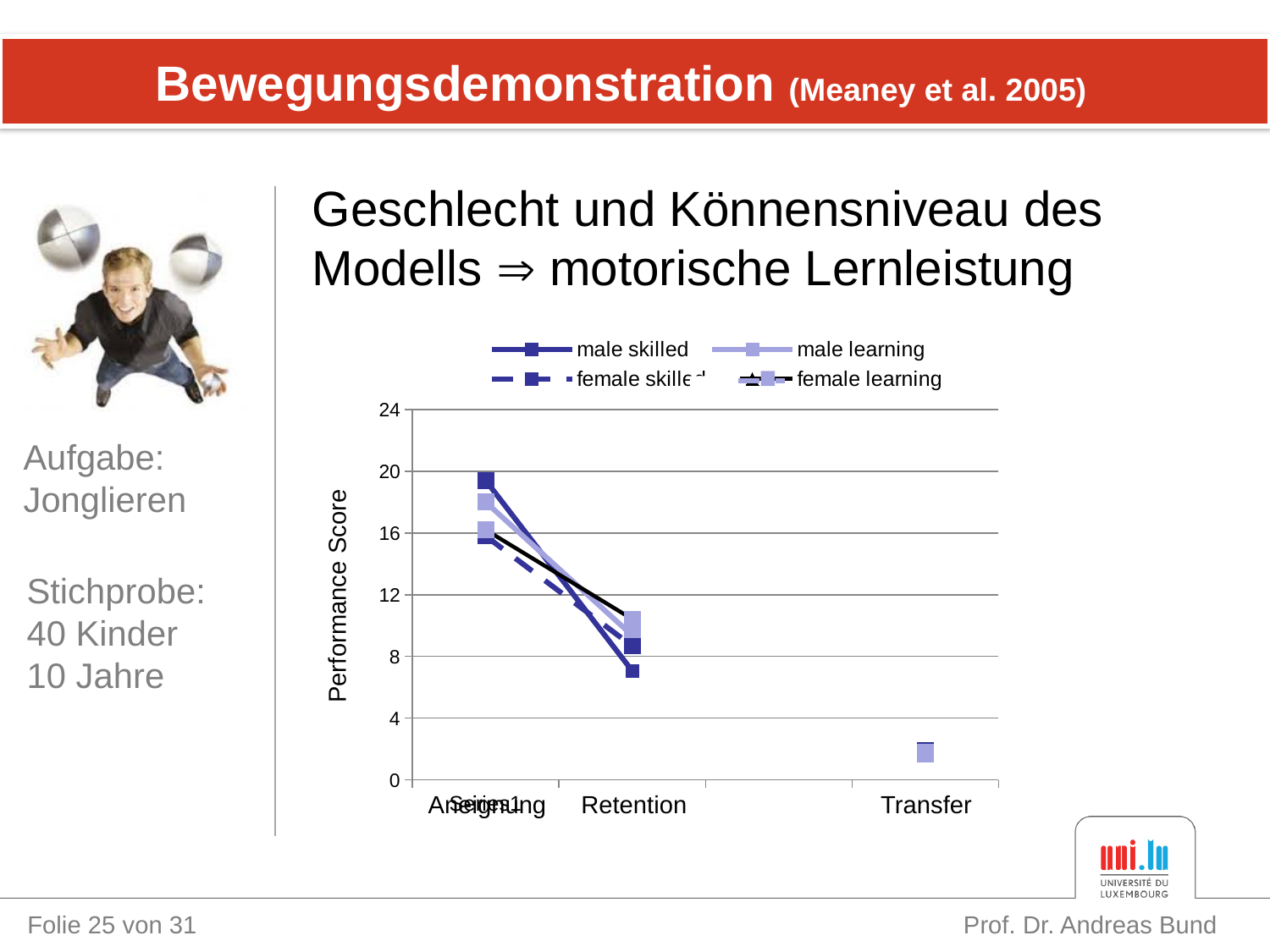
Which series is drawn with a dashed dark blue line in the legend? female skilled At Aneignung, which is larger: the value for male skilled or the value for male learning? male skilled Is the value for male skilled at Retention greater or less than 8? less How many series does the chart legend list? 4 What kind of chart is shown on the slide? line chart Which series has the highest value at Aneignung? male skilled Is the value plotted at Transfer greater or less than 4? less Is the value for male skilled at Aneignung greater or less than 16? greater What is the label of the y axis of the chart? Performance Score Which series has the lowest value at Retention? male skilled Do the series values rise or fall from Aneignung to Retention? fall